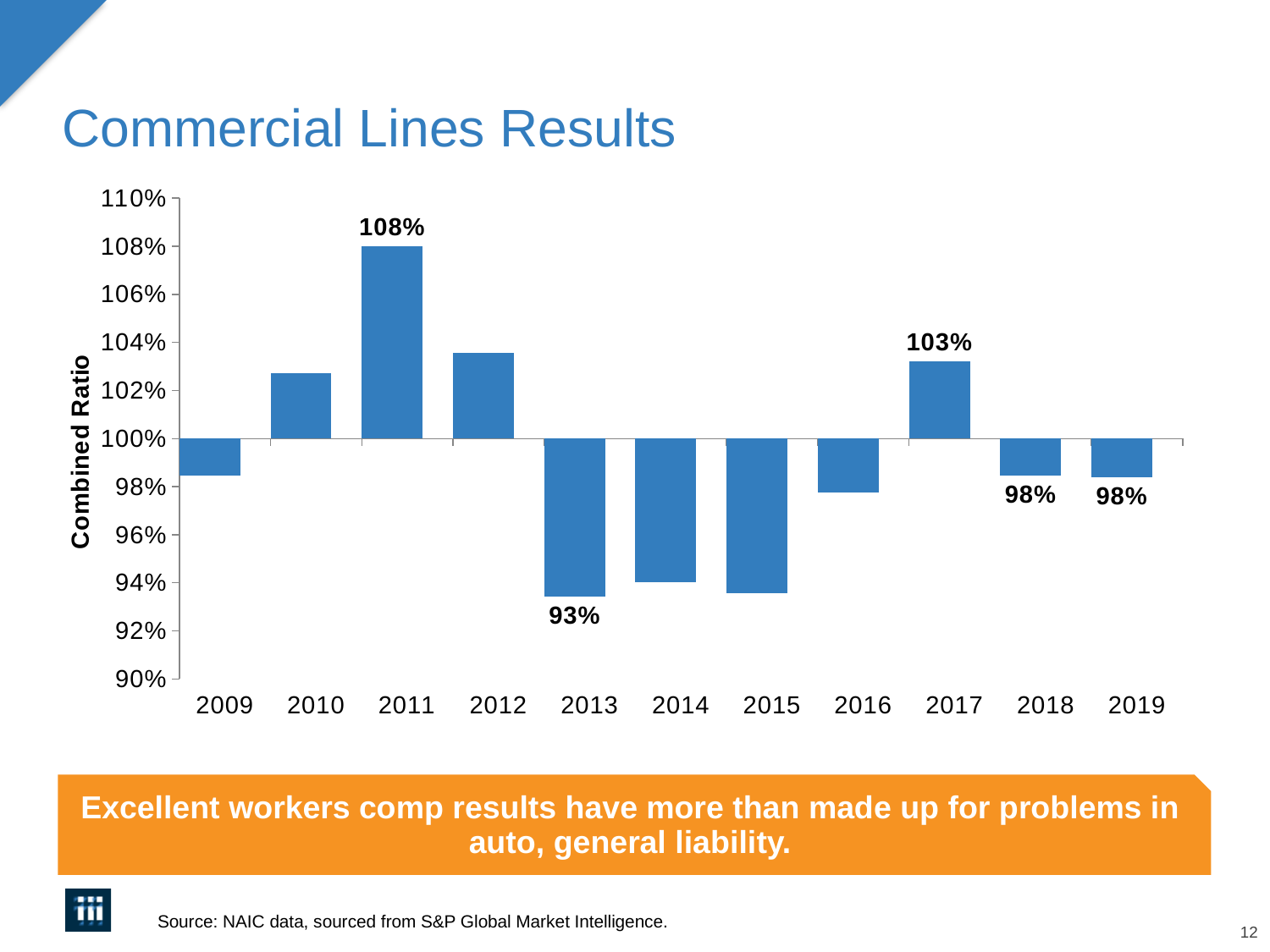
What is the combined ratio for 2011? 108% Which year has the highest combined ratio? 2011 Is the value for 2016 greater or less than 100%? less What is the combined ratio for 2017? 103% Is the value for 2010 greater or less than 102%? greater What is the label on the vertical axis? Combined Ratio What is the combined ratio for 2013? 93% What is the difference between the combined ratio in 2011 and in 2017? 5 percentage points What kind of chart is shown on the slide? bar chart Which year has a higher combined ratio, 2012 or 2014? 2012 What is the combined ratio for 2019? 98% How many years are shown on the x axis? 11